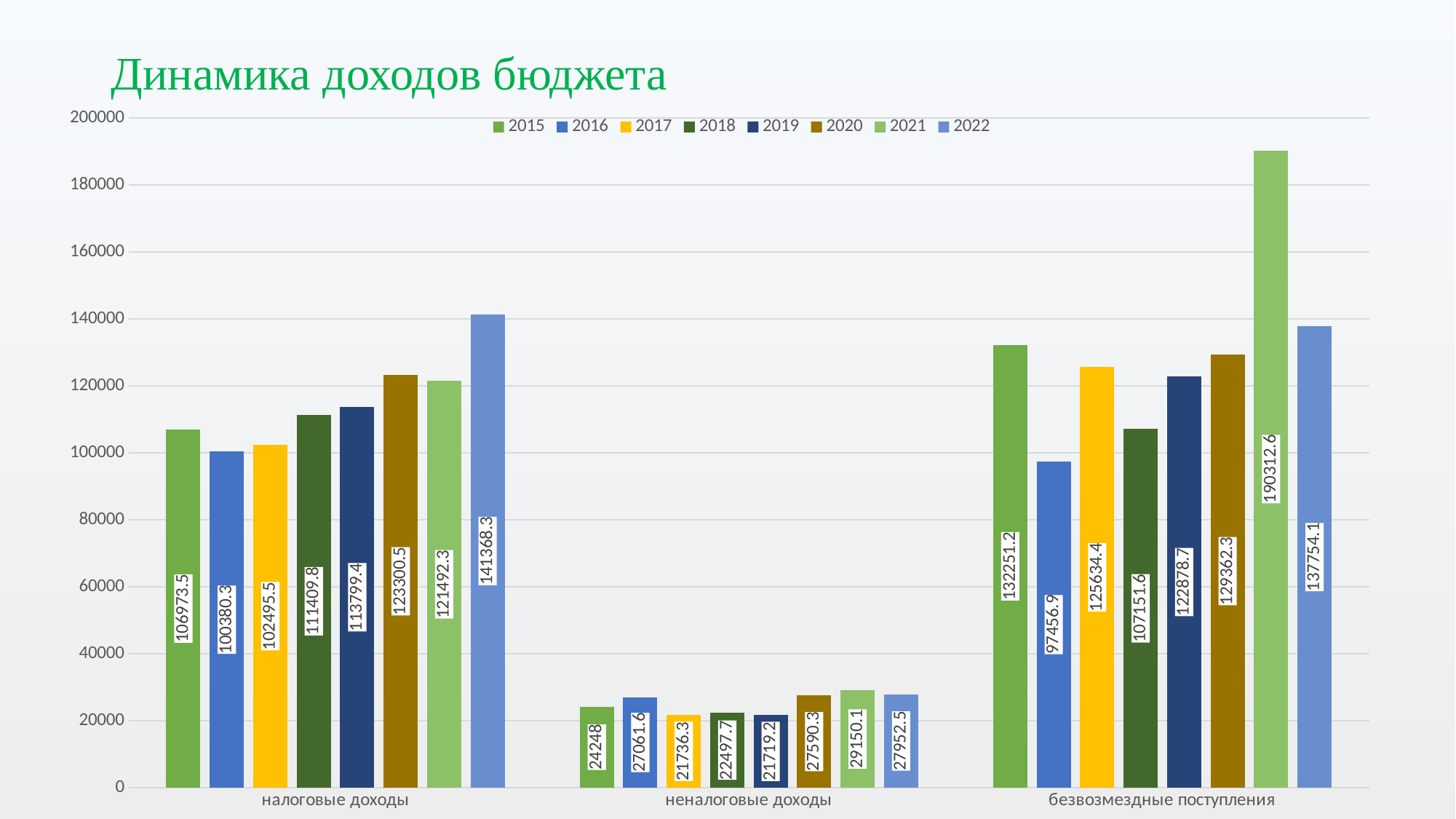
Which year has the highest value in the неналоговые доходы category? 2021 What is the value for 2021 in the безвозмездные поступления category? 190312.6 Is the value for 2022 in the безвозмездные поступления category greater or less than 120000? greater What is the difference between the 2022 and 2015 values in the налоговые доходы category? 34394.8 What is the value for 2022 in the налоговые доходы category? 141368.3 How many series does the legend list? 8 What is the value for 2015 in the неналоговые доходы category? 24248 Which year has the highest value in the безвозмездные поступления category? 2021 In the неналоговые доходы category, which is larger: the value for 2015 or for 2016? 2016 What is the difference between the 2021 and 2022 values in the безвозмездные поступления category? 52558.5 Which year has the lowest value in the безвозмездные поступления category? 2016 What is the title of the chart? Динамика доходов бюджета